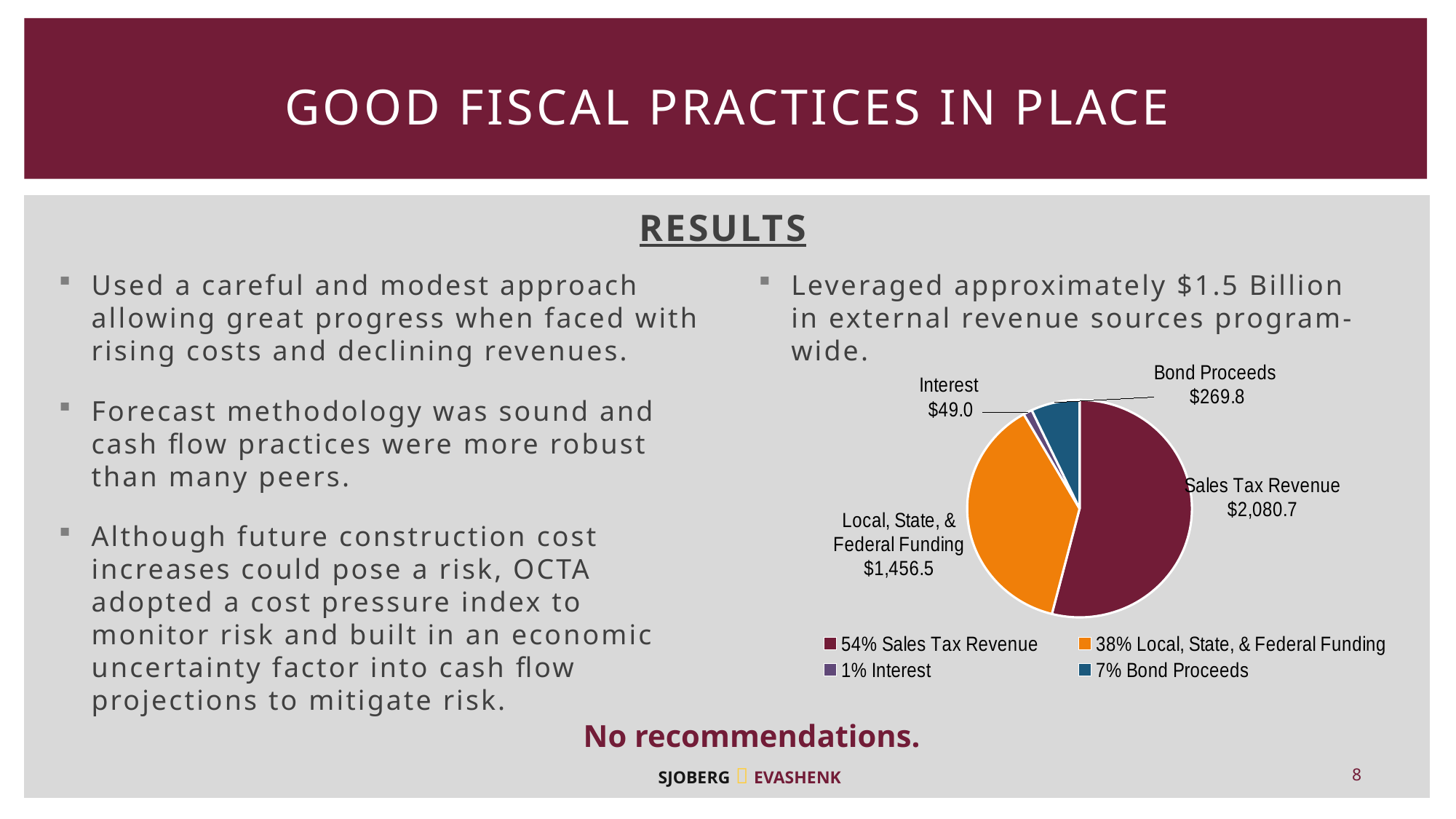
What type of chart is shown on the slide? Pie chart What is the difference between the Bond Proceeds value and the Interest value? $220.8 How many slices does the pie chart have? 4 Which category has the largest slice in the pie chart? Sales Tax Revenue What is the value shown for Bond Proceeds in the pie chart? $269.8 What share of the pie does Local, State, & Federal Funding represent? 38% Which category has the smallest slice in the pie chart? Interest Which is larger, Bond Proceeds or Interest? Bond Proceeds What is the value shown for Local, State, & Federal Funding in the pie chart? $1,456.5 What is the value shown for Sales Tax Revenue in the pie chart? $2,080.7 What is the difference between the Sales Tax Revenue value and the Local, State, & Federal Funding value? $624.2 What is the value shown for Interest in the pie chart? $49.0